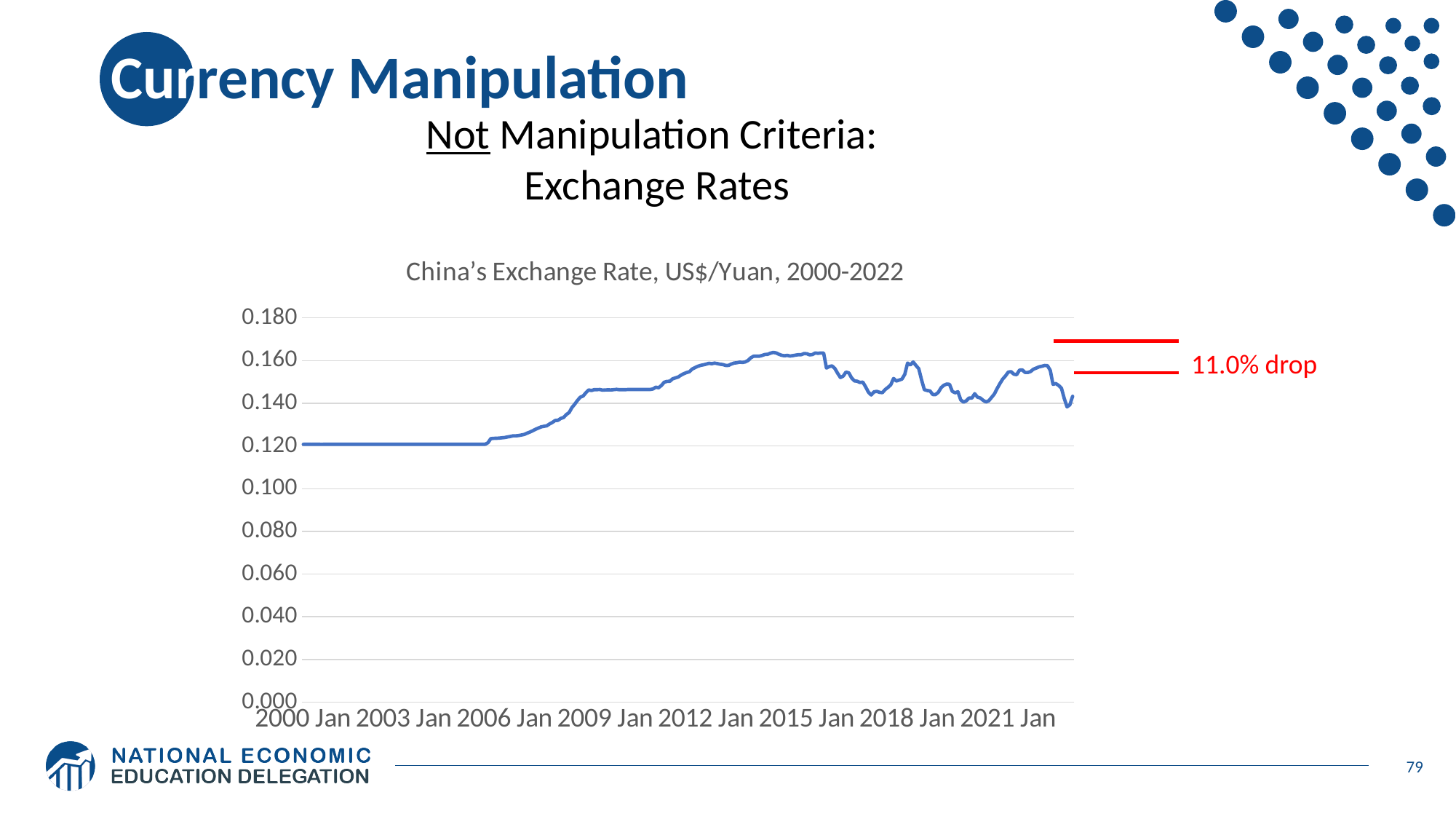
What kind of chart is shown on the slide? line chart Is the exchange rate at 2015 Jan greater or less than 0.140? greater Is the exchange rate at 2003 Jan greater or less than 0.140? less Does the exchange rate rise or fall between 2006 Jan and 2009 Jan? rise Which is larger, the exchange rate at 2003 Jan or at 2012 Jan? 2012 Jan What is the title of the chart? China's Exchange Rate, US$/Yuan, 2000-2022 Is the exchange rate at 2012 Jan greater or less than 0.140? greater What percentage drop is annotated in red on the chart? 11.0% drop How many year labels are shown on the x axis? 8 How many lines are plotted on the chart? 1